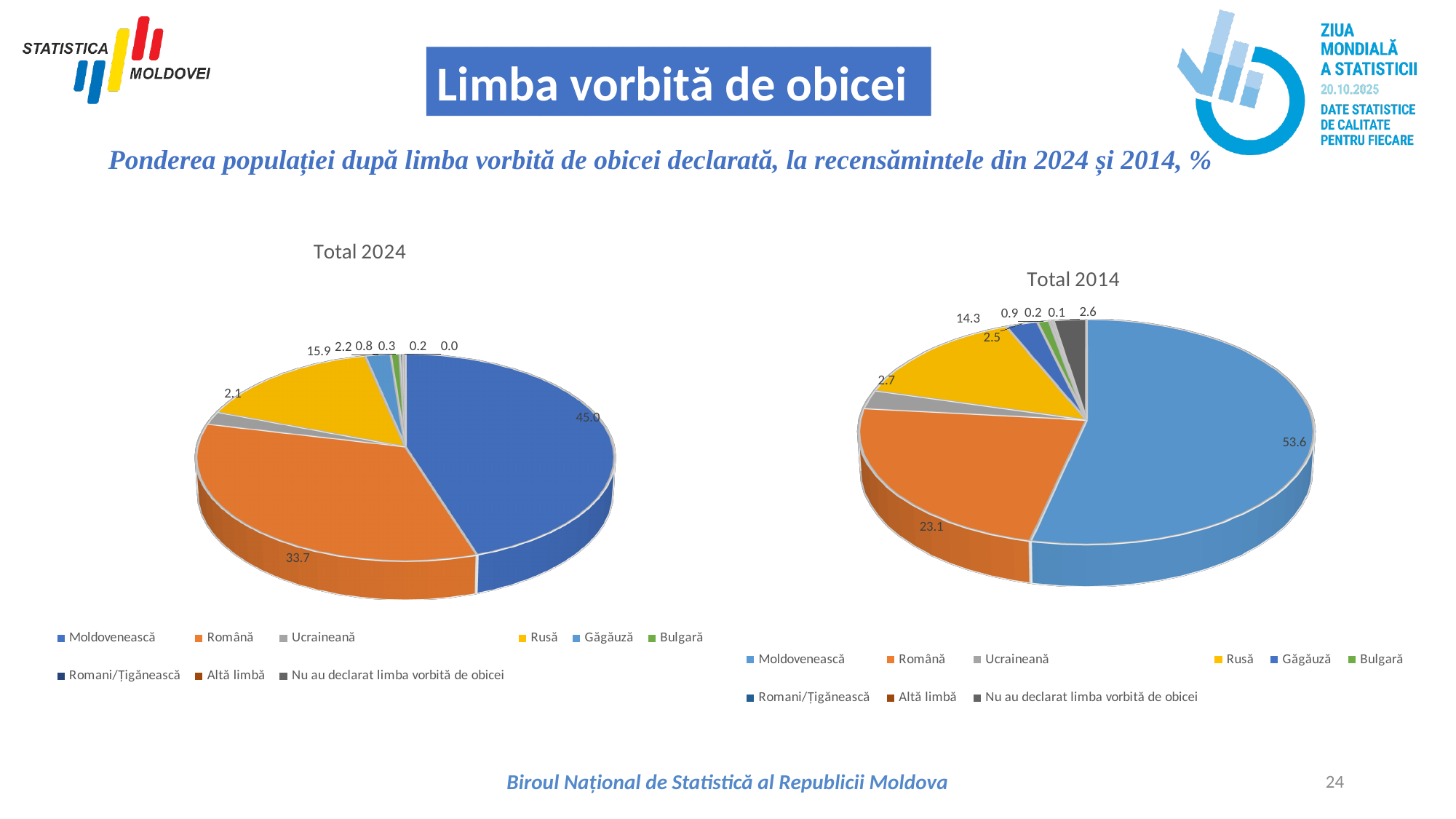
Which is larger: Română in the Total 2024 chart or Română in the Total 2014 chart? Română in the Total 2024 chart In the Total 2024 chart, which category has the largest share? Moldovenească In the Total 2024 chart, what is the difference between the values for Moldovenească and Română? 11.3 In the Total 2014 chart, what is the value for Română? 23.1 What is the title of the chart on the right side of the slide? Total 2014 What kind of chart is the Total 2024 chart? Pie chart How many categories does the legend of the Total 2014 chart list? 9 In the Total 2024 chart, what is the value for Rusă? 15.9 In the Total 2014 chart, what is the difference between the values for Moldovenească and Rusă? 39.3 In the Total 2024 chart, what is the value for Moldovenească? 45.0 In the Total 2014 chart, what is the value for Moldovenească? 53.6 In the Total 2014 chart, which category has the largest share? Moldovenească